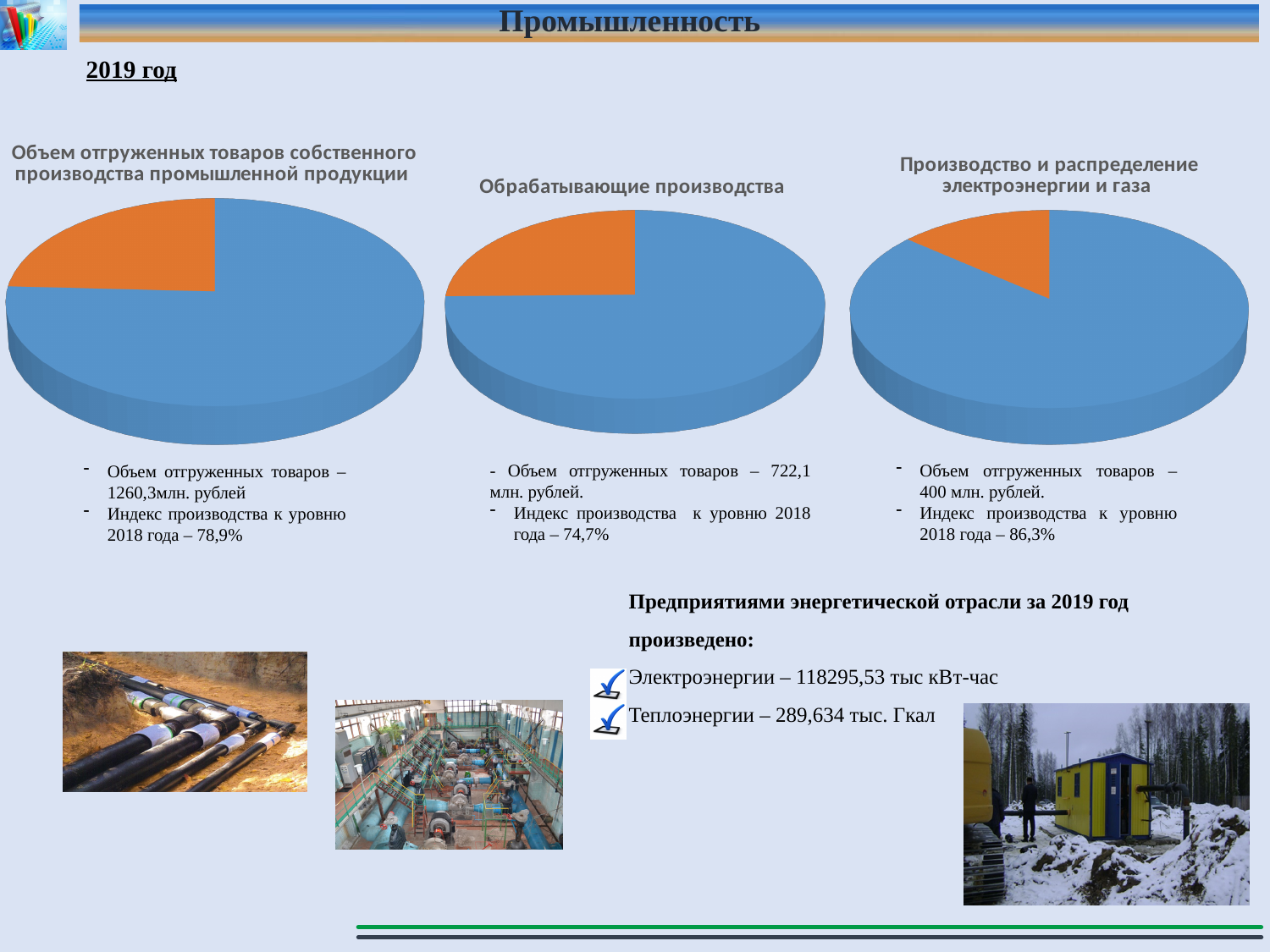
In the pie chart titled "Производство и распределение электроэнергии и газа", which slice is smaller, the blue one or the orange one? the orange one What is the title of the middle pie chart on the slide? Обрабатывающие производства In the leftmost pie chart on the slide, which slice is larger, the blue one or the orange one? the blue one How many slices does the pie chart titled "Обрабатывающие производства" have? 2 How many slices does the pie chart titled "Производство и распределение электроэнергии и газа" have? 2 What kind of chart is the leftmost chart on the slide? pie chart How many slices does the leftmost pie chart on the slide have? 2 What kind of chart is the chart titled "Обрабатывающие производства"? pie chart What is the title of the rightmost pie chart on the slide? Производство и распределение электроэнергии и газа In the pie chart titled "Обрабатывающие производства", which slice is larger, the blue one or the orange one? the blue one